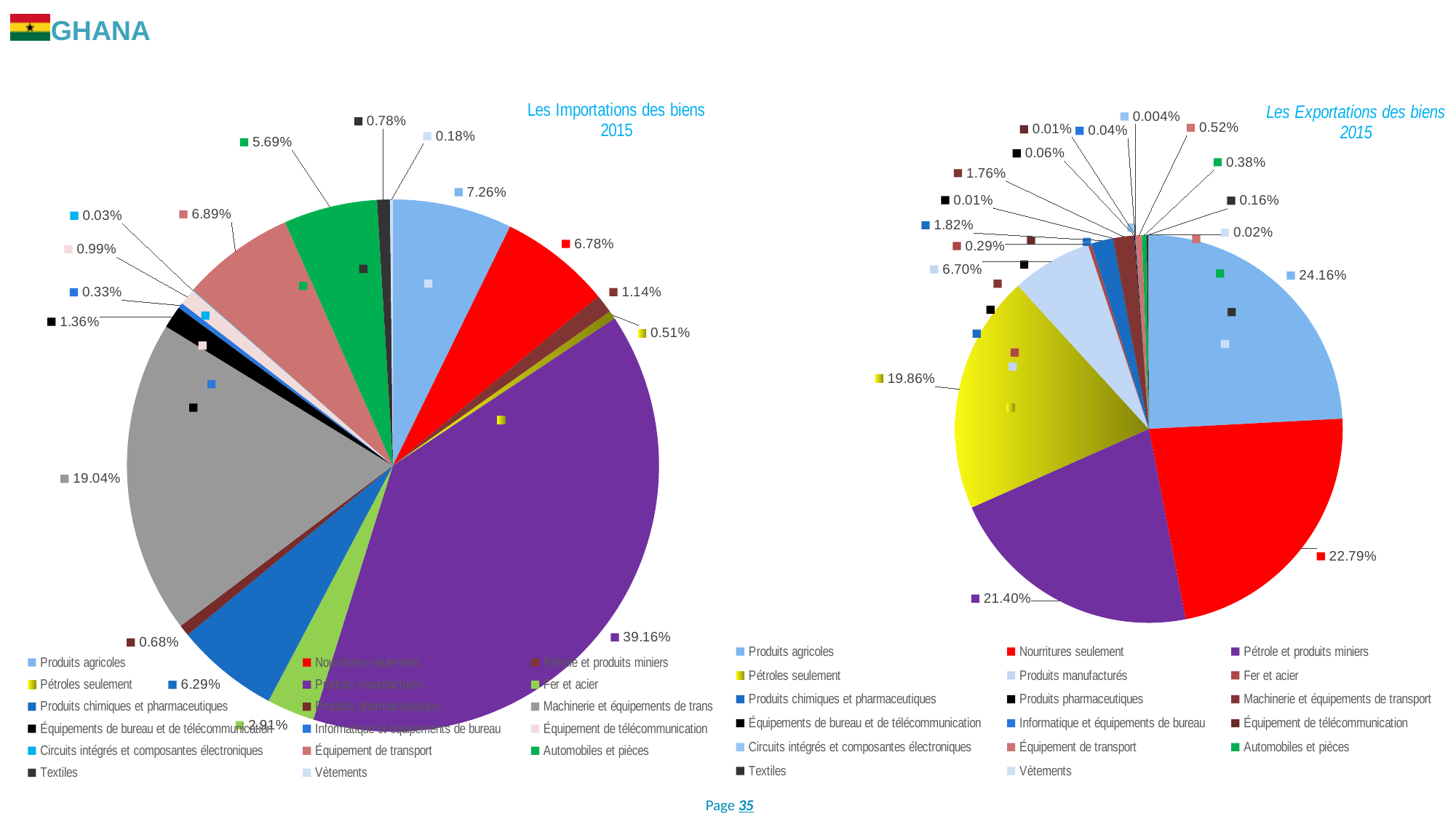
In the 'Les Importations des biens 2015' chart, what is the difference between the shares of Produits agricoles and Nourritures seulement? 0.48% In the 'Les Importations des biens 2015' chart, what share do Produits manufacturés represent? 39.16% In the 'Les Importations des biens 2015' chart, which category has the largest share? Produits manufacturés What type of chart is used for 'Les Importations des biens 2015'? pie chart In the 'Les Exportations des biens 2015' chart, which category has the largest share? Produits agricoles In the 'Les Exportations des biens 2015' chart, what is the share of Pétroles seulement? 19.86% In the 'Les Exportations des biens 2015' chart, what is the difference between the shares of Produits agricoles and Nourritures seulement? 1.37% How many categories does the legend of the 'Les Exportations des biens 2015' chart list? 17 In the 'Les Exportations des biens 2015' chart, which is larger: Nourritures seulement or Pétrole et produits miniers? Nourritures seulement In the 'Les Exportations des biens 2015' chart, what is the share of Produits agricoles? 24.16% What is the title of the pie chart on the left of the slide? Les Importations des biens 2015 In the 'Les Importations des biens 2015' chart, what is the share of Machinerie et équipements de transport? 19.04%